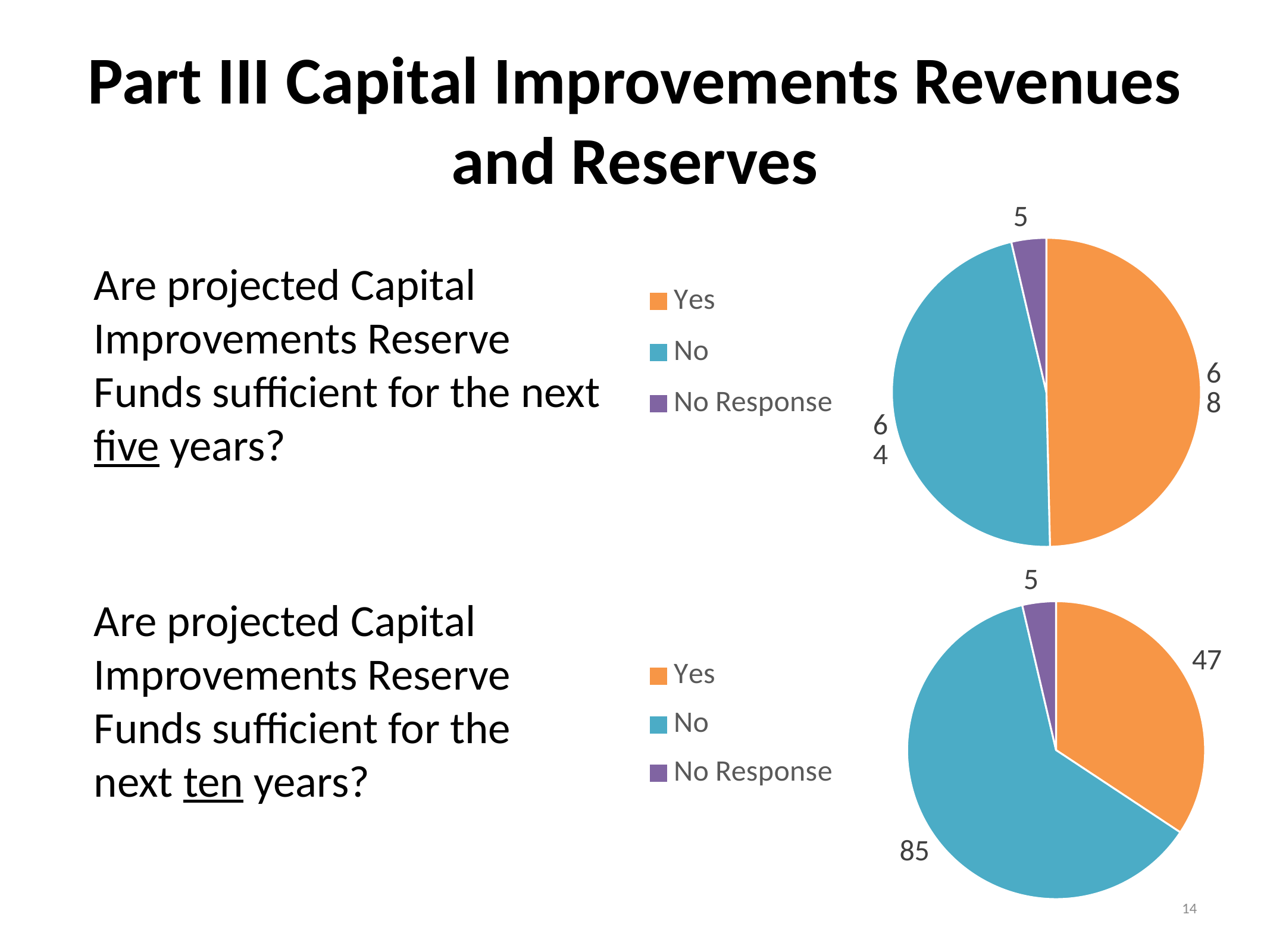
In the top pie chart (five years), what is the value for Yes? 68 In the bottom pie chart (ten years), what is the difference between the No and Yes values? 38 In the bottom pie chart (ten years), what is the value for No? 85 How many entries does the legend of the bottom pie chart (ten years) list? 3 In the top pie chart (five years), what is the value for No? 64 In the bottom pie chart (ten years), what is the value for Yes? 47 What kind of chart is used for the five-year question (top chart)? Pie chart In the bottom pie chart (ten years), which category has the largest slice? No In the top pie chart (five years), what is the value for No Response? 5 In the top pie chart (five years), what colour is the No slice? Blue In the top pie chart (five years), which is larger, Yes or No? Yes In the top pie chart (five years), which category has the smallest slice? No Response